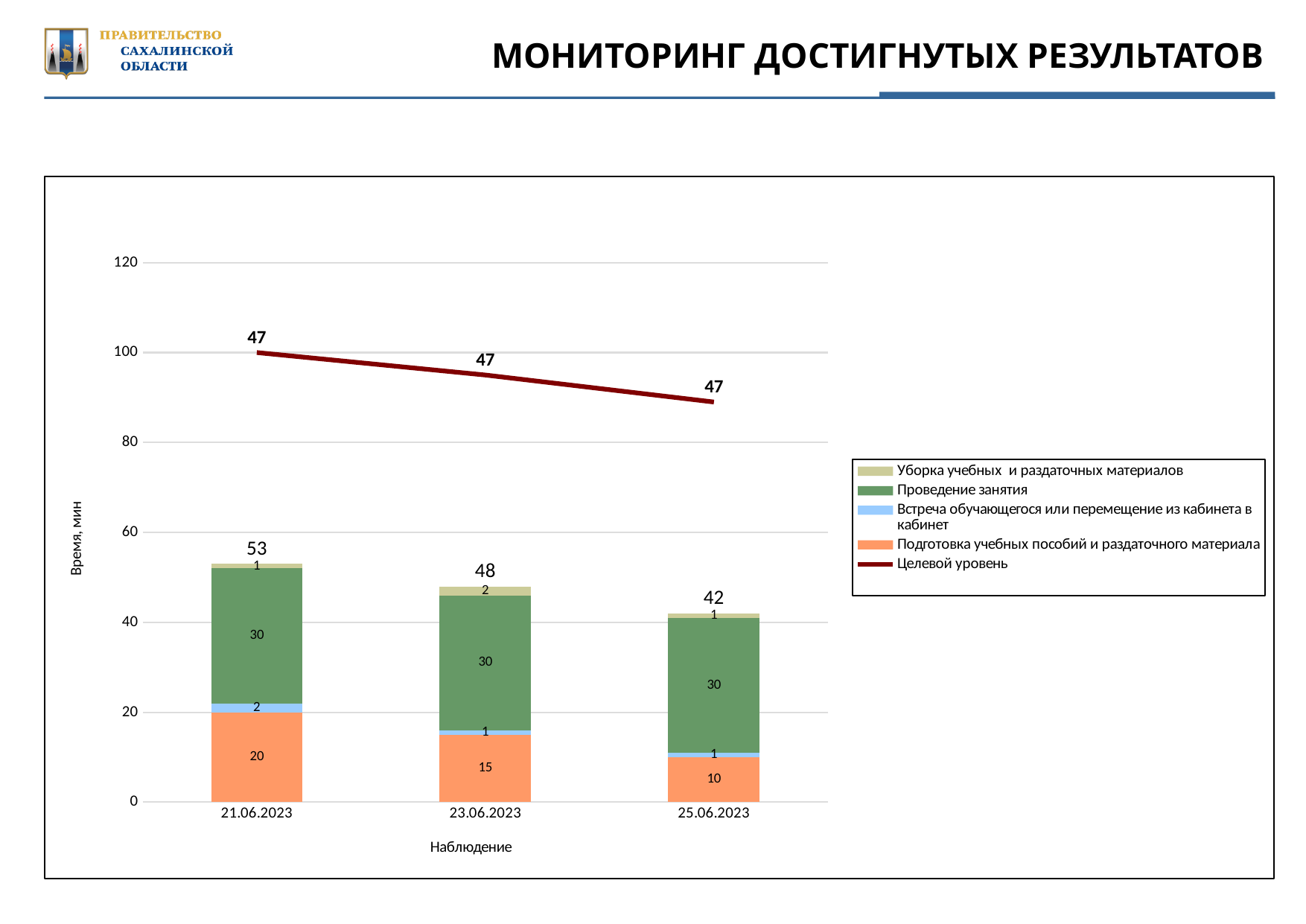
Which observation date has the highest stacked bar total? 21.06.2023 What is the total of the stacked bar for 21.06.2023? 53 What is the value of 'Проведение занятия' for 25.06.2023? 30 What is the difference between the 'Подготовка учебных пособий и раздаточного материала' values for 21.06.2023 and 25.06.2023? 10 Which observation date has the lowest stacked bar total? 25.06.2023 Do the stacked bar totals rise or fall from 21.06.2023 to 25.06.2023? fall What is the value of 'Встреча обучающегося или перемещение из кабинета в кабинет' for 21.06.2023? 2 What is the total of the stacked bar for 25.06.2023? 42 What is the value of 'Уборка учебных и раздаточных материалов' for 23.06.2023? 2 What is the value of 'Подготовка учебных пособий и раздаточного материала' for 23.06.2023? 15 What is the labelled value of 'Целевой уровень' at 23.06.2023? 47 How many series does the legend list? 5